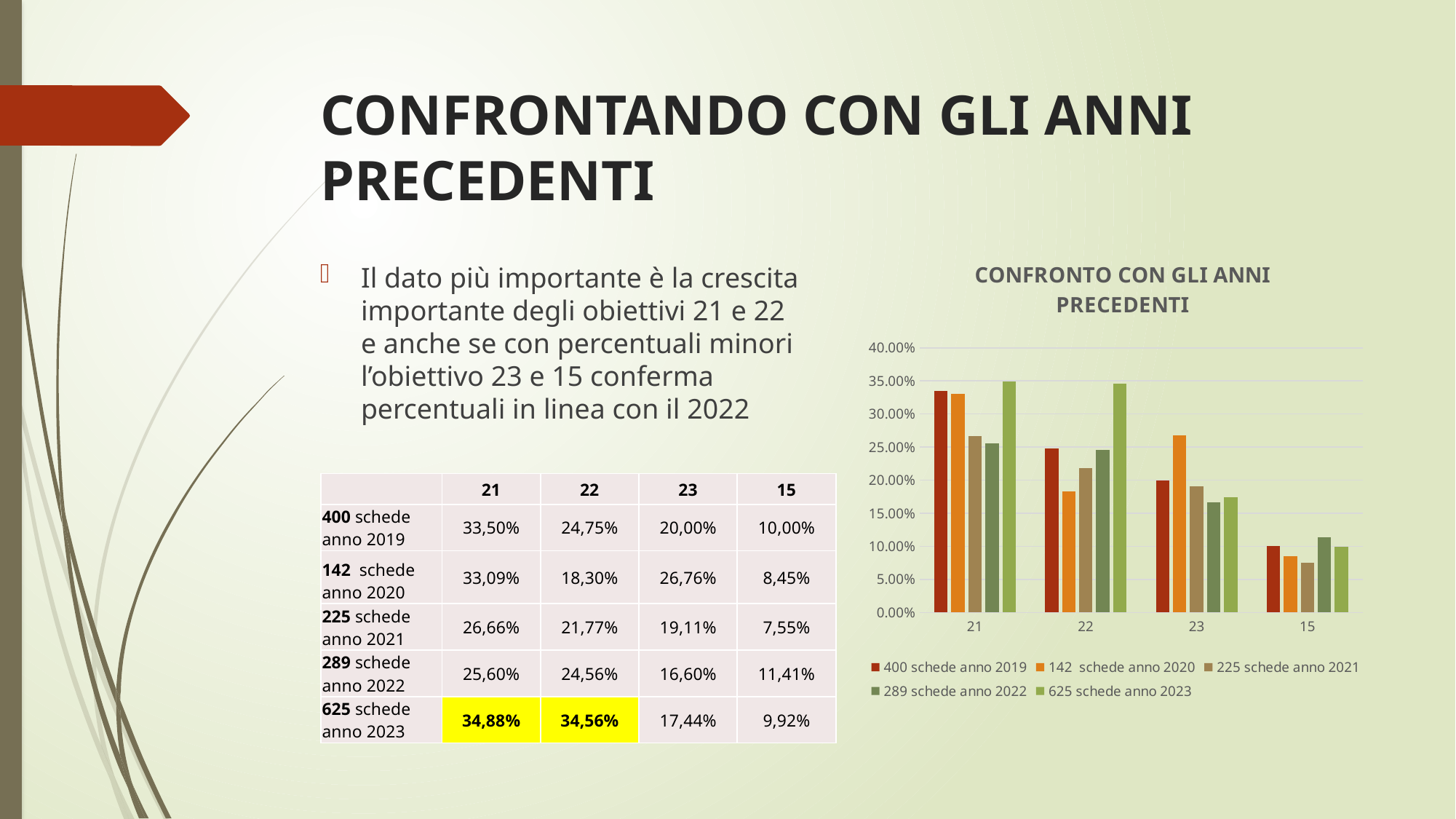
At category 21, which series has the highest value? 625 schede anno 2023 What is the difference between '625 schede anno 2023' and '400 schede anno 2019' at category 21? 1,38% How many categories are shown on the x axis of the chart? 4 What is the title of the chart? CONFRONTO CON GLI ANNI PRECEDENTI How many series does the chart legend list? 5 At category 15, which series has the lowest value? 225 schede anno 2021 What is the value for '400 schede anno 2019' at category 15? 10,00% What kind of chart is shown on the slide? bar chart Do the values for '625 schede anno 2023' rise or fall across the categories from 21 to 15? fall What is the value for '625 schede anno 2023' at category 21? 34,88% At category 22, which is larger: '400 schede anno 2019' or '142 schede anno 2020'? 400 schede anno 2019 Is the value for '142 schede anno 2020' at category 23 greater or less than 25.00%? greater